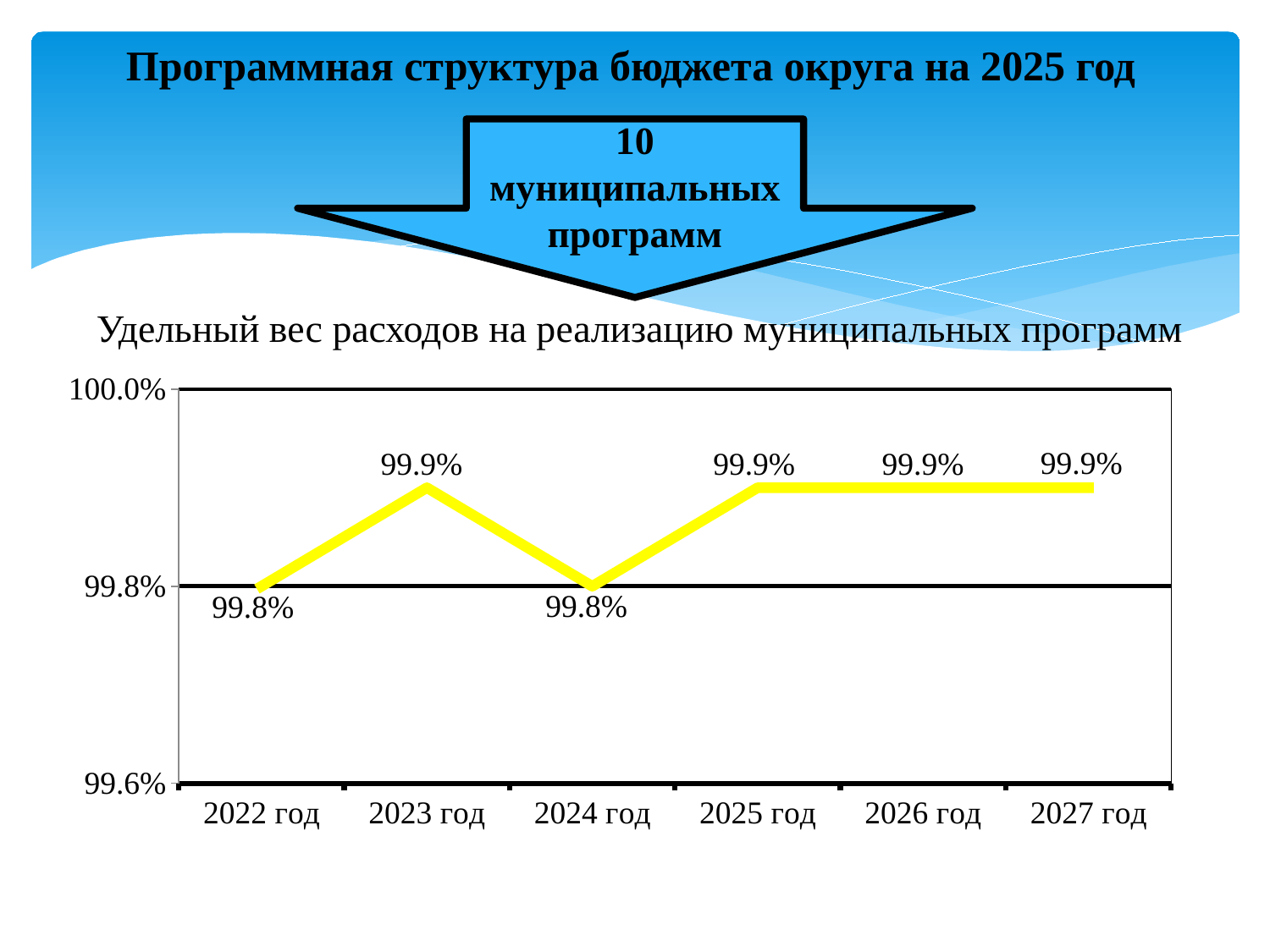
What is the value for 2023 год? 99.9% Does the value rise or fall from 2024 год to 2025 год? rise What kind of chart is shown on the slide? line chart What is the highest value plotted on the chart? 99.9% Is the value for 2026 год greater or less than 99.8%? greater What is the lowest value plotted on the chart? 99.8% What is the value for 2027 год? 99.9% What is the value for 2024 год? 99.8% Which is larger, the value for 2022 год or the value for 2025 год? 2025 год What is the value for 2022 год? 99.8% What is the difference between the values for 2023 год and 2024 год? 0.1% How many years are shown on the x axis of the chart? 6